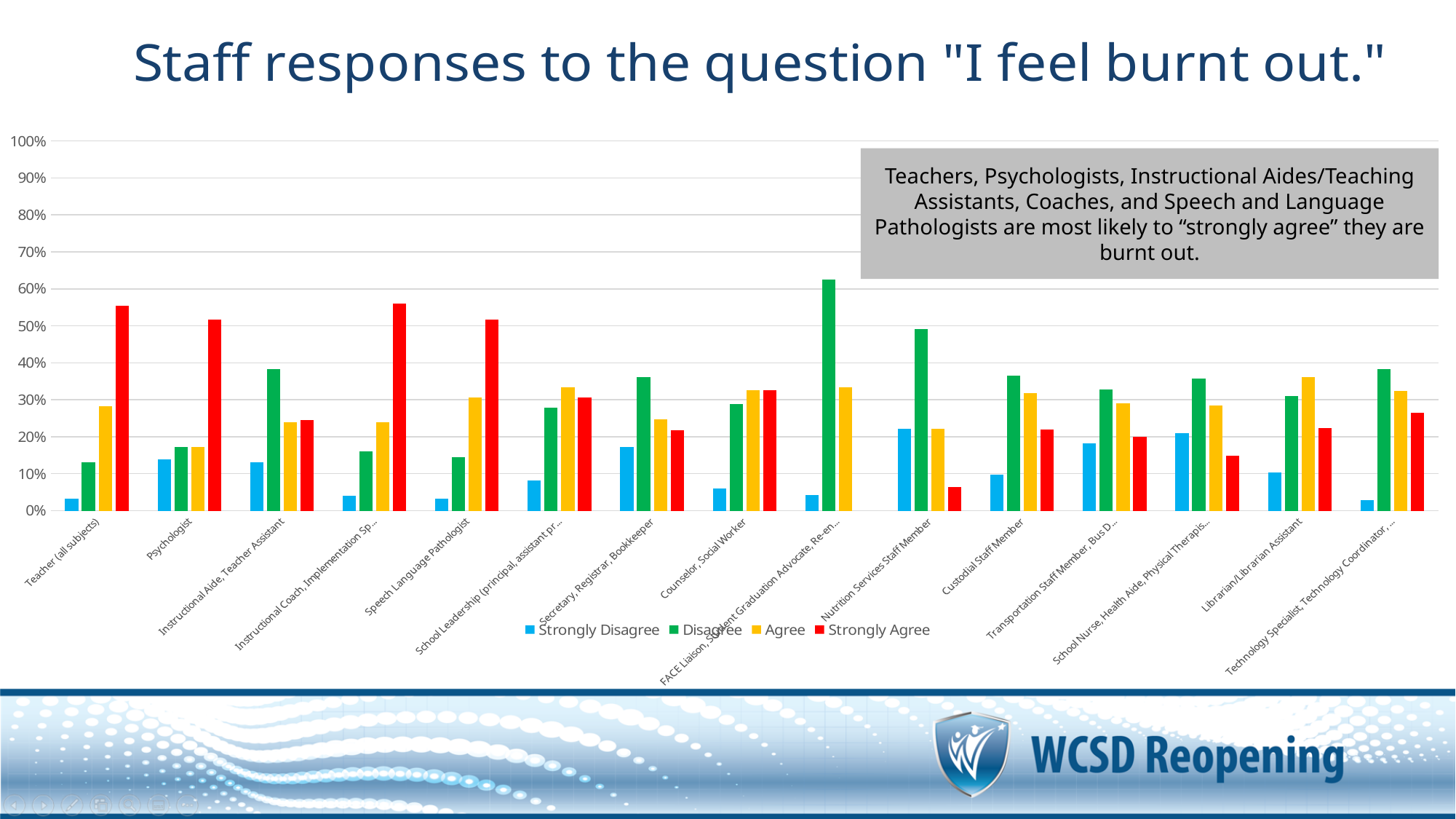
Which colour represents the Strongly Agree series in the legend? red Is the Disagree value for FACE Liaison, Student Graduation Advocate greater or less than 50%? greater For Custodial Staff Member, which is larger: the Disagree value or the Strongly Agree value? Disagree Is the Agree value for Librarian/Librarian Assistant greater or less than 30%? greater How many series does the legend list? 4 Which staff category has the highest Disagree value? FACE Liaison, Student Graduation Advocate, Re-en... What kind of chart is shown on the slide? bar chart Is the Strongly Agree value for Nutrition Services Staff Member greater or less than 10%? less Which staff category has the lowest Strongly Agree value? Nutrition Services Staff Member For Teacher (all subjects), which is larger: the Strongly Agree value or the Agree value? Strongly Agree How many staff categories are shown along the x axis? 15